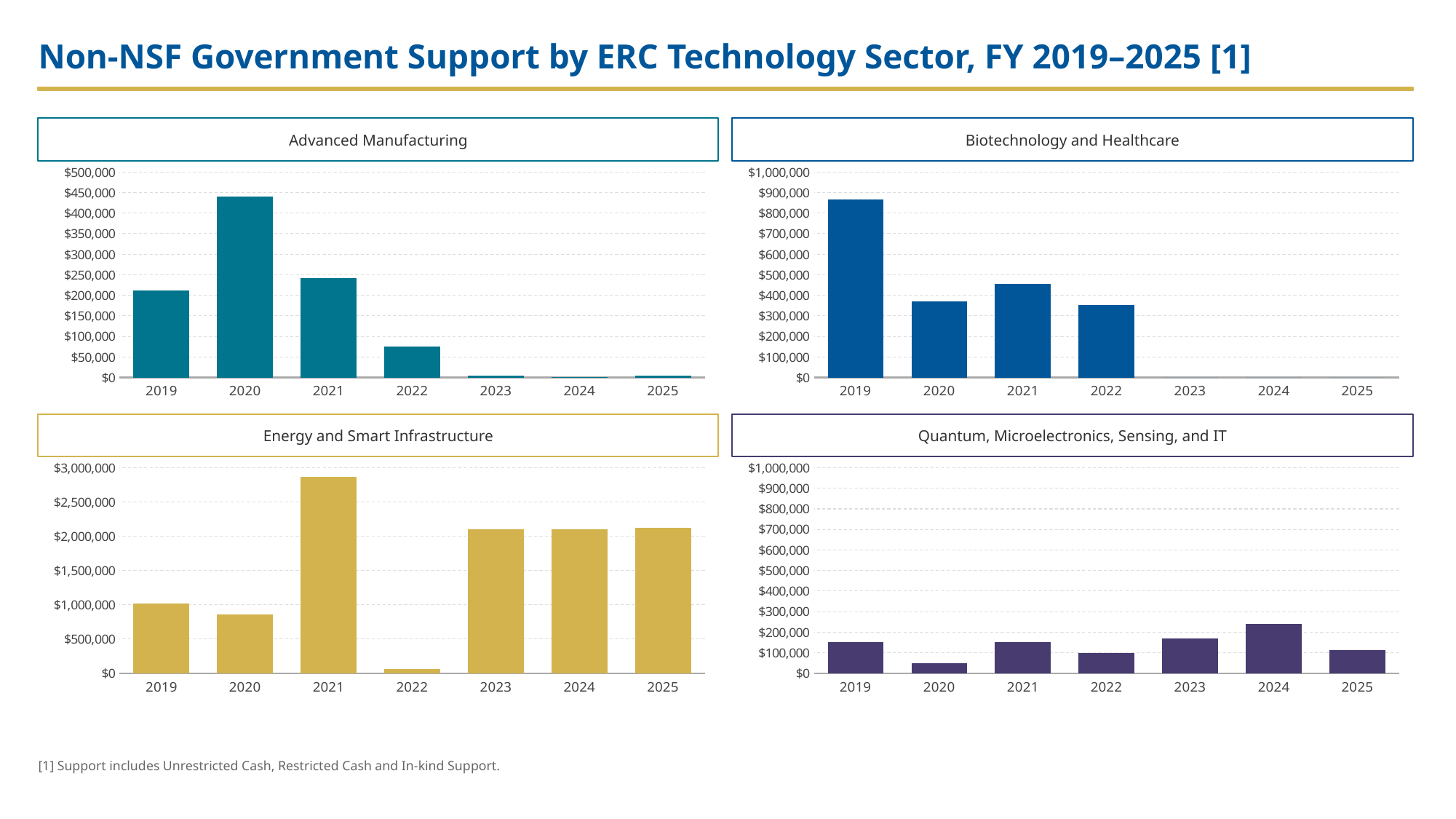
In the Advanced Manufacturing chart, is the value for 2020 greater or less than $400,000? greater How many years are shown on the x axis of the Quantum, Microelectronics, Sensing, and IT chart? 7 In the Energy and Smart Infrastructure chart, which year has the highest value? 2021 In the Energy and Smart Infrastructure chart, is the value for 2019 greater or less than $500,000? greater In the Biotechnology and Healthcare chart, which year has the highest value? 2019 In the Advanced Manufacturing chart, is the value for 2022 greater or less than $100,000? less In the Quantum, Microelectronics, Sensing, and IT chart, which year has the lowest value? 2020 In the Biotechnology and Healthcare chart, which is larger, the value for 2021 or the value for 2022? 2021 In the Quantum, Microelectronics, Sensing, and IT chart, which year has the highest value? 2024 In the Energy and Smart Infrastructure chart, which year has the lowest value? 2022